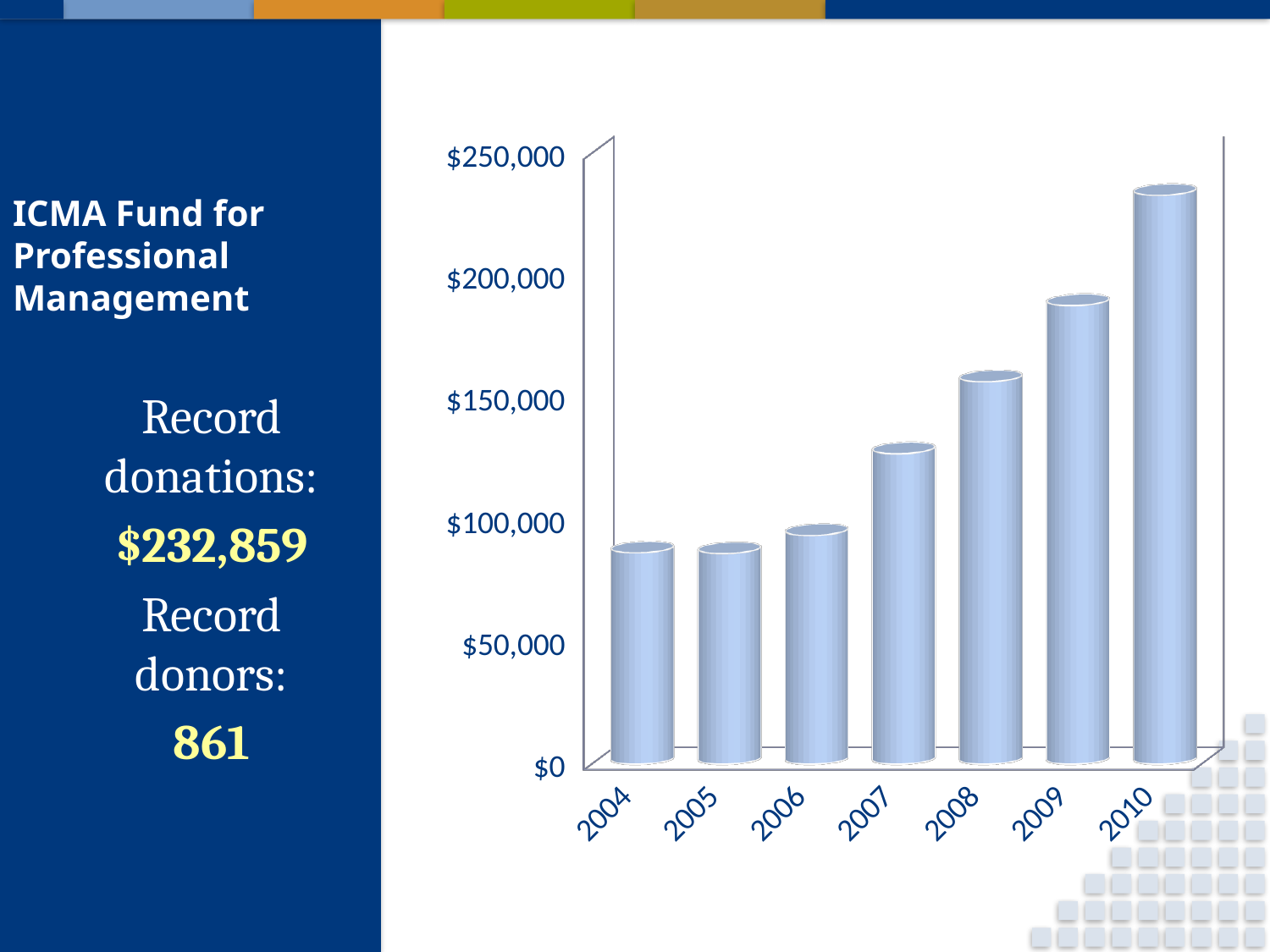
How many years are plotted on the chart? 7 Which is larger, the value for 2006 or the value for 2009? 2009 Which year has the highest value on the chart? 2010 Is the value for 2009 greater or less than $200,000? less Is the value for 2010 greater or less than $200,000? greater Is the value for 2004 greater or less than $100,000? less Do the values generally rise or fall from 2004 to 2010? Rise Which is larger, the value for 2007 or the value for 2008? 2008 What is the first year shown on the x axis? 2004 What kind of chart is shown on the slide? Bar chart